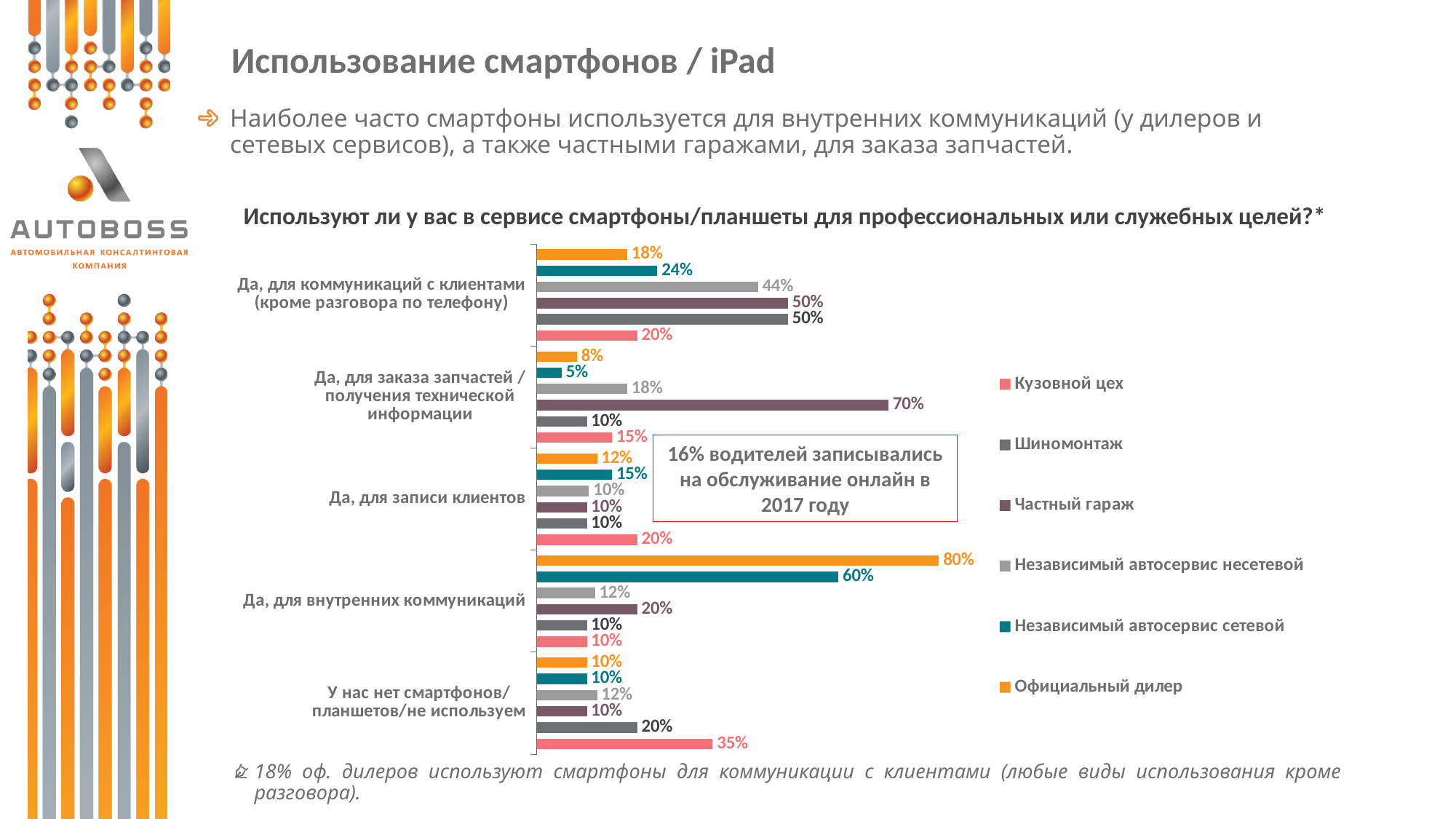
What is the difference between Официальный дилер and Независимый автосервис сетевой in the category 'Да, для внутренних коммуникаций'? 20% What is the value for Независимый автосервис несетевой in the category 'Да, для коммуникаций с клиентами (кроме разговора по телефону)'? 44% What is the value for Официальный дилер in the category 'Да, для внутренних коммуникаций'? 80% What is the value for Частный гараж in the category 'Да, для заказа запчастей / получения технической информации'? 70% How many categories are shown on the chart? 5 What does the text box inside the chart say? 16% водителей записывались на обслуживание онлайн в 2017 году What type of chart is shown on the slide? bar chart Which series has the lowest value in the category 'Да, для заказа запчастей / получения технической информации'? Независимый автосервис сетевой How many series does the legend list? 6 What is the value for Кузовной цех in the category 'У нас нет смартфонов/планшетов/не используем'? 35% Which series has the highest value in the category 'Да, для внутренних коммуникаций'? Официальный дилер In the category 'У нас нет смартфонов/планшетов/не используем', which is larger: Шиномонтаж or Кузовной цех? Кузовной цех